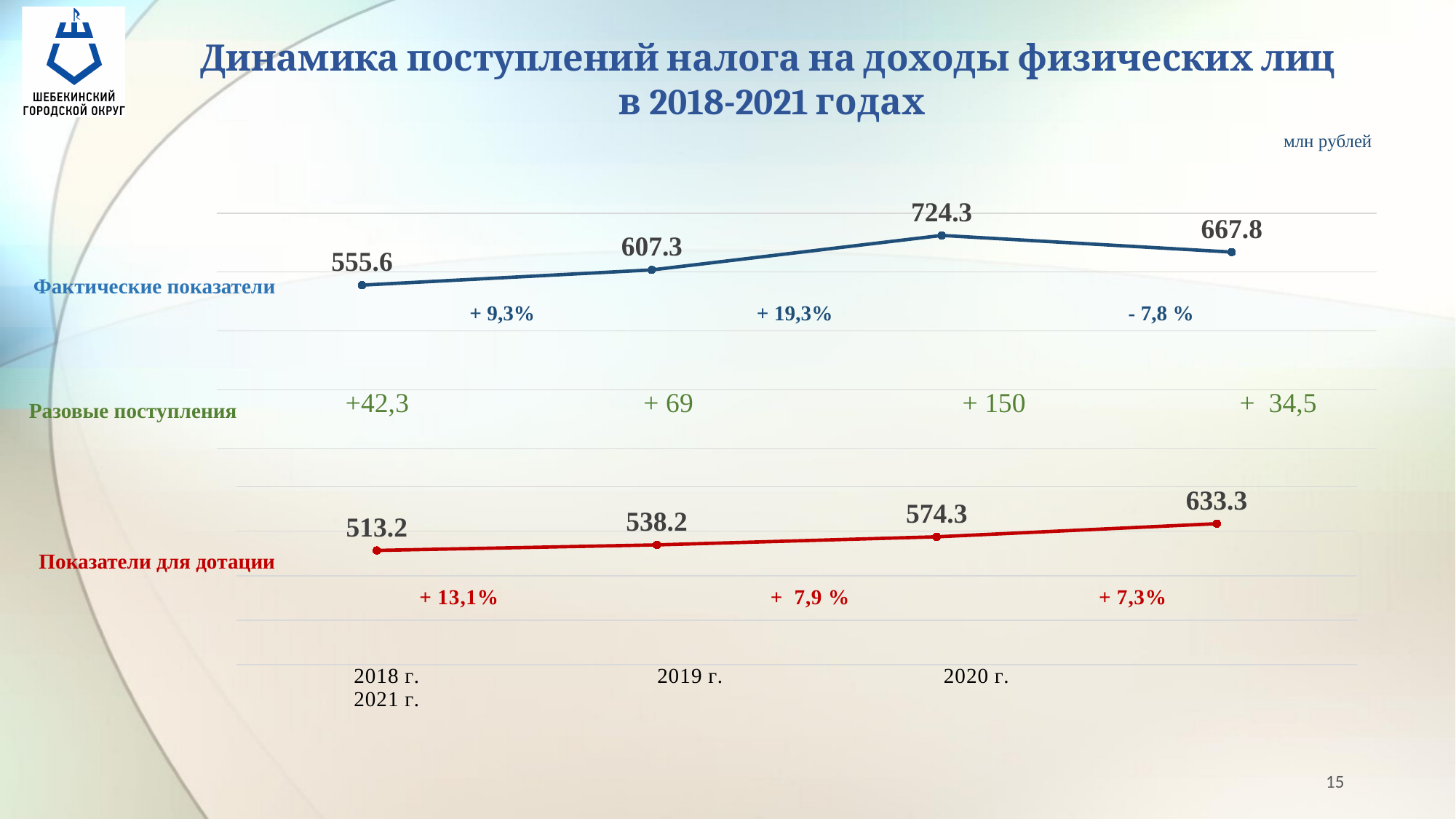
Do the values in the lower chart (Показатели для дотации) rise or fall from 2018 to 2021? Rise In the upper chart (Фактические показатели), which year has the highest value? 2020 In the lower chart (Показатели для дотации), what is the value for 2019? 538.2 How many years (data points) are plotted in the lower chart (Показатели для дотации)? 4 What is the difference between the Фактические показатели value for 2020 and for 2021? 56.5 In the lower chart (Показатели для дотации), which year has the lowest value? 2018 What unit of measurement is indicated for the values on the slide? млн рублей Which is larger for 2021: the Фактические показатели value or the Показатели для дотации value? Фактические показатели What type of chart is used on the slide to show the tax revenue dynamics? Line chart In the upper chart (Фактические показатели), what is the value for 2018? 555.6 In the lower chart (Показатели для дотации), what is the value for 2021? 633.3 In the upper chart (Фактические показатели), what is the value for 2020? 724.3